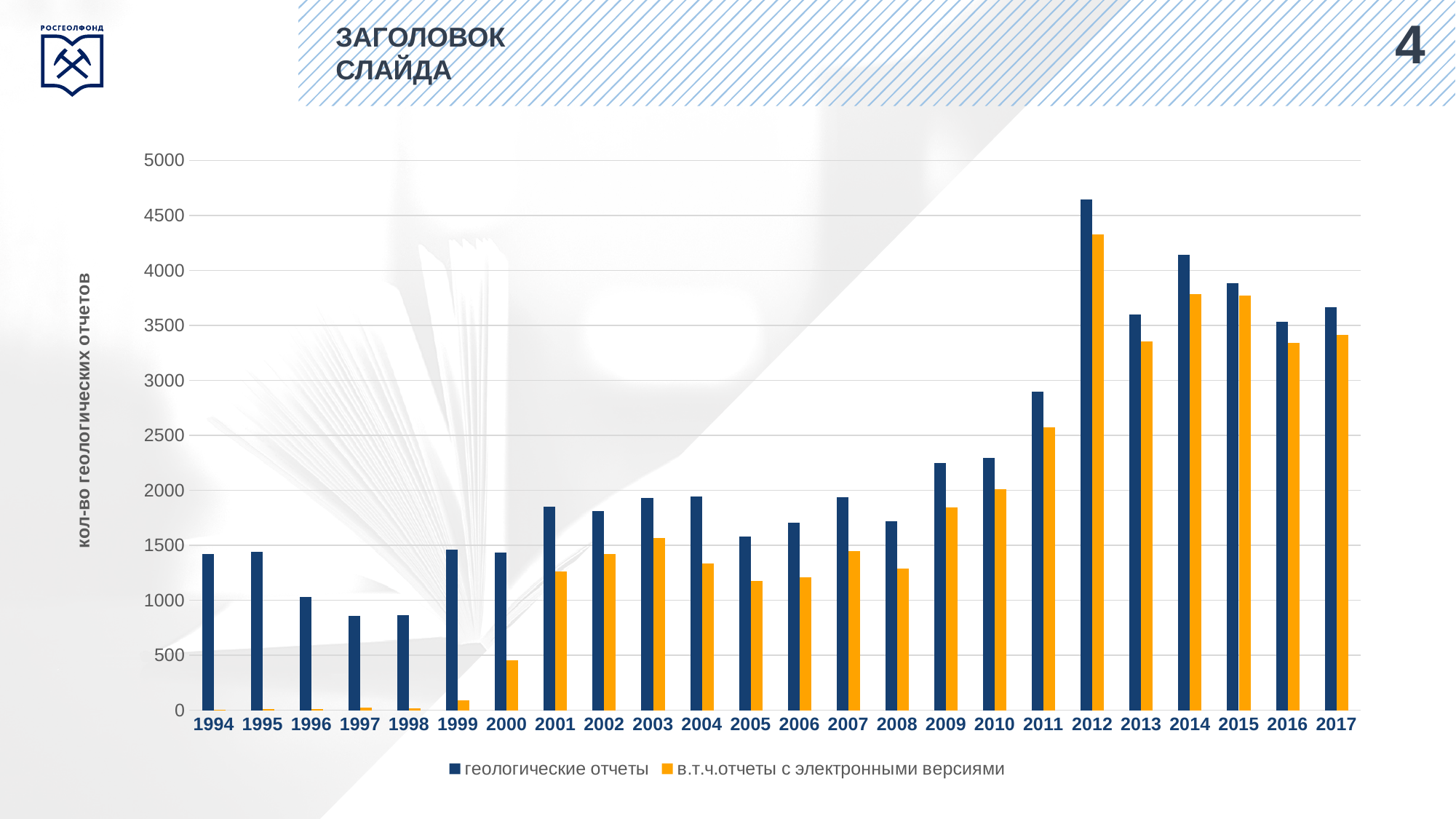
Is the value for геологические отчеты in 2012 greater or less than 4500? greater How many years are shown on the x axis? 24 Do the values for геологические отчеты rise or fall from 2008 to 2012? rise Is the value for геологические отчеты in 2011 greater or less than 2500? greater Is the value for в.т.ч.отчеты с электронными версиями in 2014 greater or less than 4000? less In which year is the value for геологические отчеты highest? 2012 Which year has the larger value for в.т.ч.отчеты с электронными версиями, 2010 or 2011? 2011 Which year has the larger value for геологические отчеты, 2012 or 2014? 2012 What kind of chart is shown on the slide? bar chart How many series does the legend list? 2 In which year is the value for в.т.ч.отчеты с электронными версиями highest? 2012